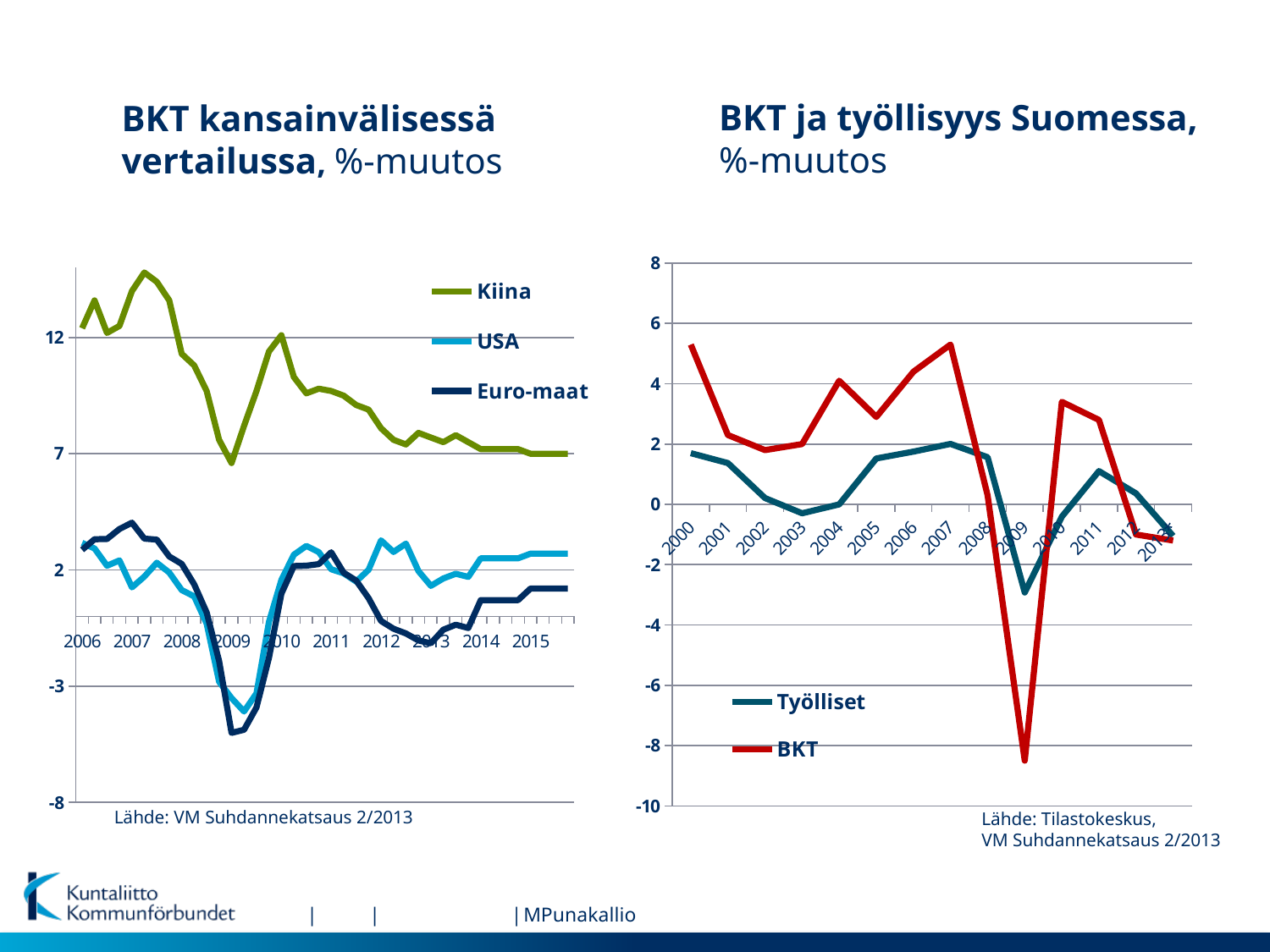
How many series does the legend of the right chart 'BKT ja työllisyys Suomessa' list? 2 In the left chart 'BKT kansainvälisessä vertailussa', is the value for Euro-maat in 2009 greater or less than -3? less In the left chart 'BKT kansainvälisessä vertailussa', does the Kiina line rise or fall from 2007 to 2009? fall In the right chart 'BKT ja työllisyys Suomessa', is the value for Työlliset in 2009 greater or less than -2? less In the left chart 'BKT kansainvälisessä vertailussa', which series is lower in 2013, USA or Euro-maat? Euro-maat In the right chart 'BKT ja työllisyys Suomessa', is the value for BKT in 2009 greater or less than -6? less How many years are labelled on the x axis of the right chart 'BKT ja työllisyys Suomessa'? 14 What kind of chart is the left chart, 'BKT kansainvälisessä vertailussa, %-muutos'? line chart In the left chart 'BKT kansainvälisessä vertailussa', which series has the highest values throughout the period? Kiina How many series does the legend of the left chart 'BKT kansainvälisessä vertailussa' list? 3 In the right chart 'BKT ja työllisyys Suomessa', in which year is the BKT value lowest? 2009